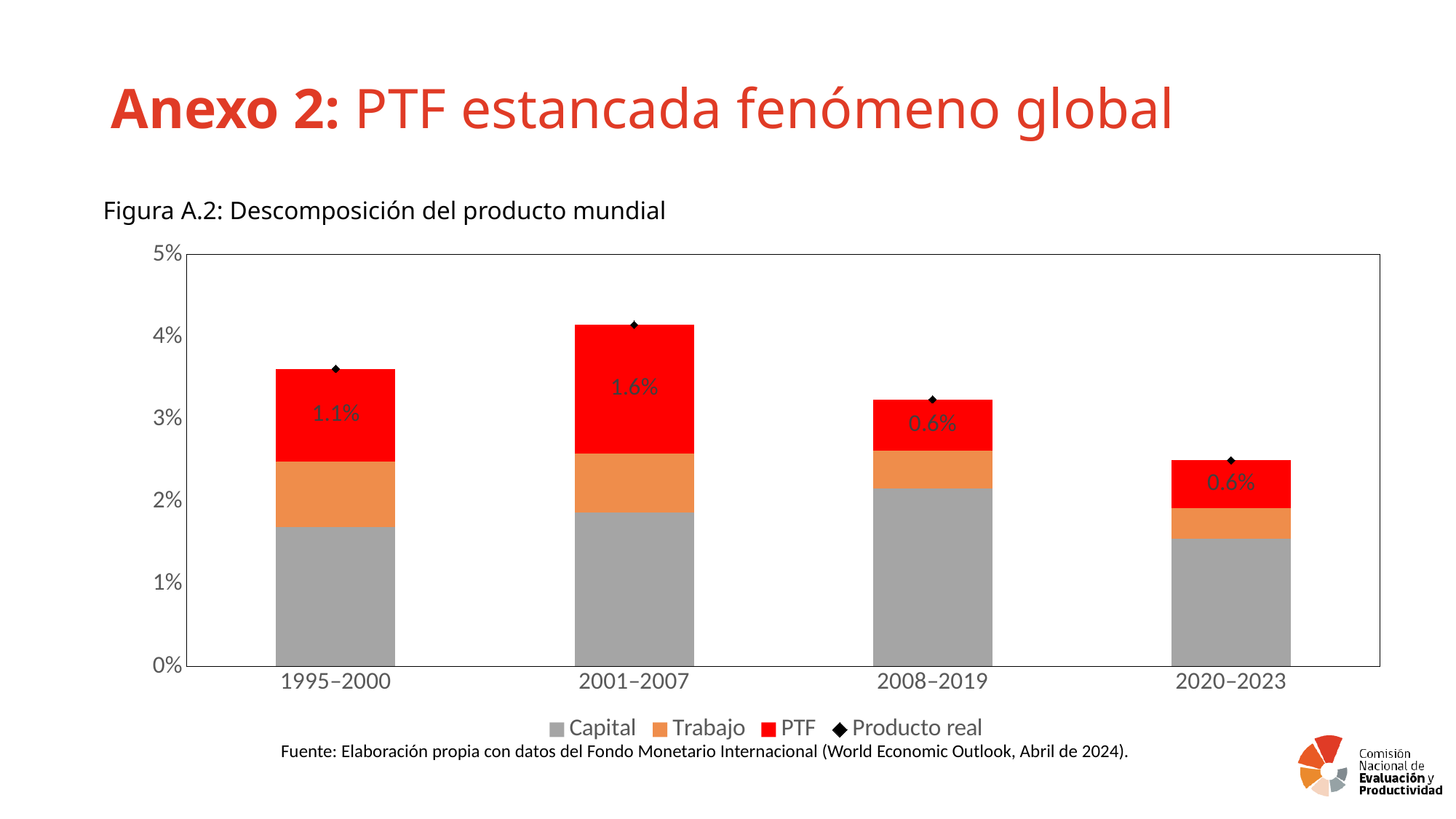
What is the PTF value for 2020–2023? 0.6% Which period has a larger PTF value, 1995–2000 or 2008–2019? 1995–2000 In which period is the PTF contribution highest? 2001–2007 What is the PTF value for 2001–2007? 1.6% What is the title of the figure? Figura A.2: Descomposición del producto mundial Is the Producto real value for 2020–2023 greater or less than 3%? less What kind of chart is shown on the slide? Stacked bar chart What is the difference between the PTF value for 2001–2007 and for 1995–2000? 0.5% How many periods are shown on the x axis? 4 What is the PTF value for 1995–2000? 1.1% What is the PTF value for 2008–2019? 0.6% How many series does the legend list? 4